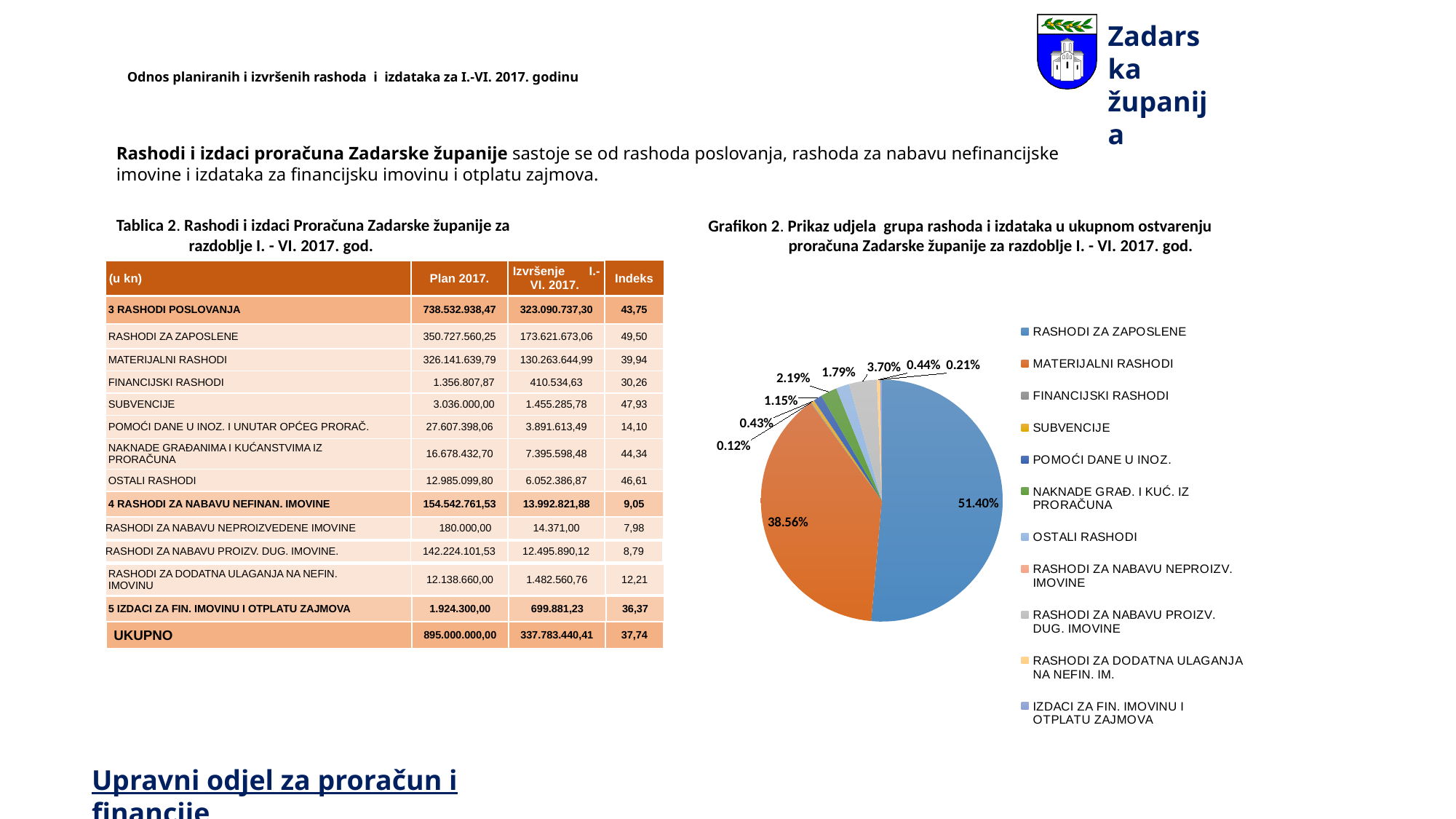
Which category has the largest share of the pie chart? RASHODI ZA ZAPOSLENE What share of the pie does MATERIJALNI RASHODI have? 38.56% What share of the pie does RASHODI ZA ZAPOSLENE have? 51.40% What is the smallest percentage value labelled on the pie chart? 0.12% What share of the pie does RASHODI ZA NABAVU PROIZV. DUG. IMOVINE have? 3.70% What colour is the slice for MATERIJALNI RASHODI in the pie chart? orange How many entries does the legend of the pie chart list? 11 What is the title of the pie chart? Grafikon 2. Prikaz udjela grupa rashoda i izdataka u ukupnom ostvarenju proračuna Zadarske županije za razdoblje I. - VI. 2017. god. What kind of chart is shown on the slide? pie chart What is the difference in percentage points between the RASHODI ZA ZAPOSLENE slice and the MATERIJALNI RASHODI slice? 12.84% Which slice is larger, RASHODI ZA ZAPOSLENE or MATERIJALNI RASHODI? RASHODI ZA ZAPOSLENE What is the largest percentage value labelled on the pie chart? 51.40%